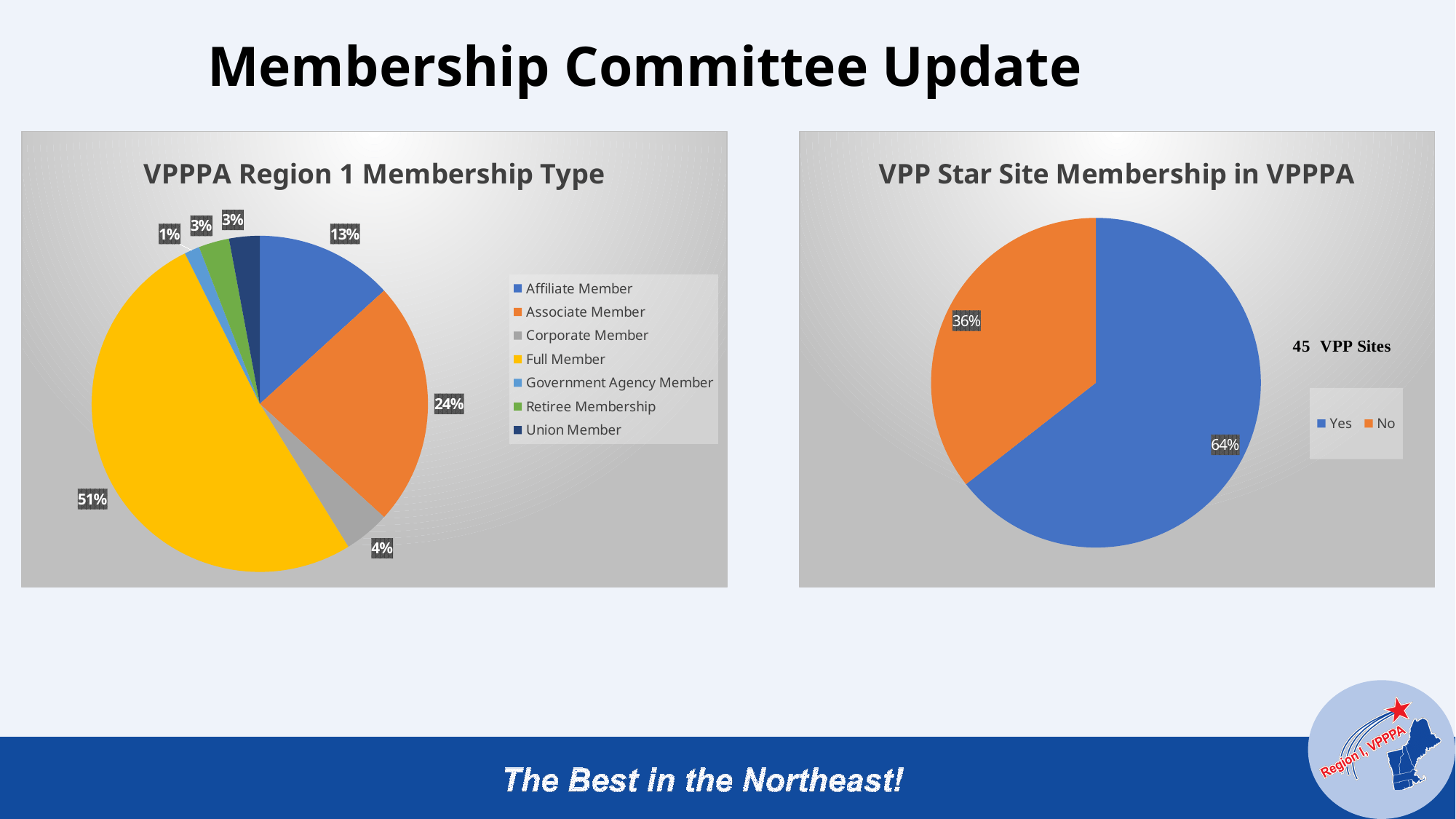
In the 'VPP Star Site Membership in VPPPA' chart, what percentage is shown for 'No'? 36% What kind of chart is 'VPP Star Site Membership in VPPPA'? Pie chart In the 'VPPPA Region 1 Membership Type' chart, how many membership types does the legend list? 7 In the 'VPPPA Region 1 Membership Type' chart, what is the difference in percentage points between Full Member and Associate Member? 27 In the 'VPPPA Region 1 Membership Type' chart, what percentage is shown for Affiliate Member? 13% In the 'VPPPA Region 1 Membership Type' chart, which membership type has the largest share? Full Member In the 'VPP Star Site Membership in VPPPA' chart, how many VPP Sites are noted next to the pie? 45 In the 'VPP Star Site Membership in VPPPA' chart, what share of the pie is 'Yes'? 64% In the 'VPPPA Region 1 Membership Type' chart, which is larger, Affiliate Member or Corporate Member? Affiliate Member In the 'VPPPA Region 1 Membership Type' chart, which membership type has the smallest share? Government Agency Member In the 'VPPPA Region 1 Membership Type' chart, what percentage is shown for Associate Member? 24% In the 'VPPPA Region 1 Membership Type' chart, what share of the pie is Full Member? 51%